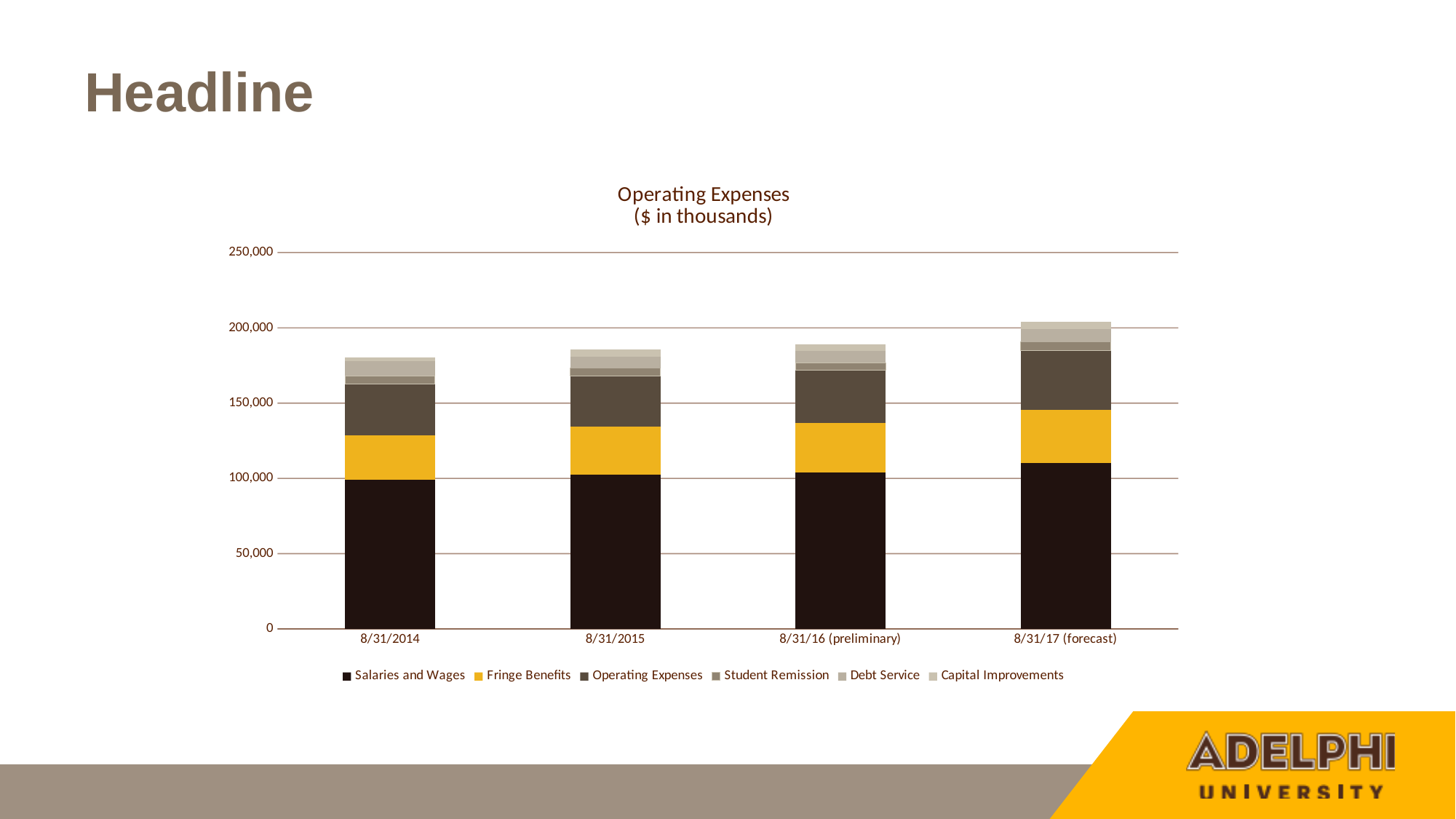
How many dates (categories) are shown on the x axis? 4 Which date has the highest total operating expenses? 8/31/17 (forecast) Which date has the lowest total operating expenses? 8/31/2014 Which is larger: the Salaries and Wages segment for 8/31/17 (forecast) or for 8/31/2014? 8/31/17 (forecast) Is the total stacked bar for 8/31/17 (forecast) greater or less than 200,000? greater Which series is shown in yellow? Fringe Benefits Is the total stacked bar for 8/31/2014 greater or less than 200,000? less What kind of chart is shown on the slide? Stacked bar chart How many series does the legend list? 6 What is the title of the chart? Operating Expenses ($ in thousands) Do total operating expenses rise or fall from 8/31/2014 to 8/31/17 (forecast)? Rise Is the Salaries and Wages value for 8/31/17 (forecast) greater or less than 100,000? greater